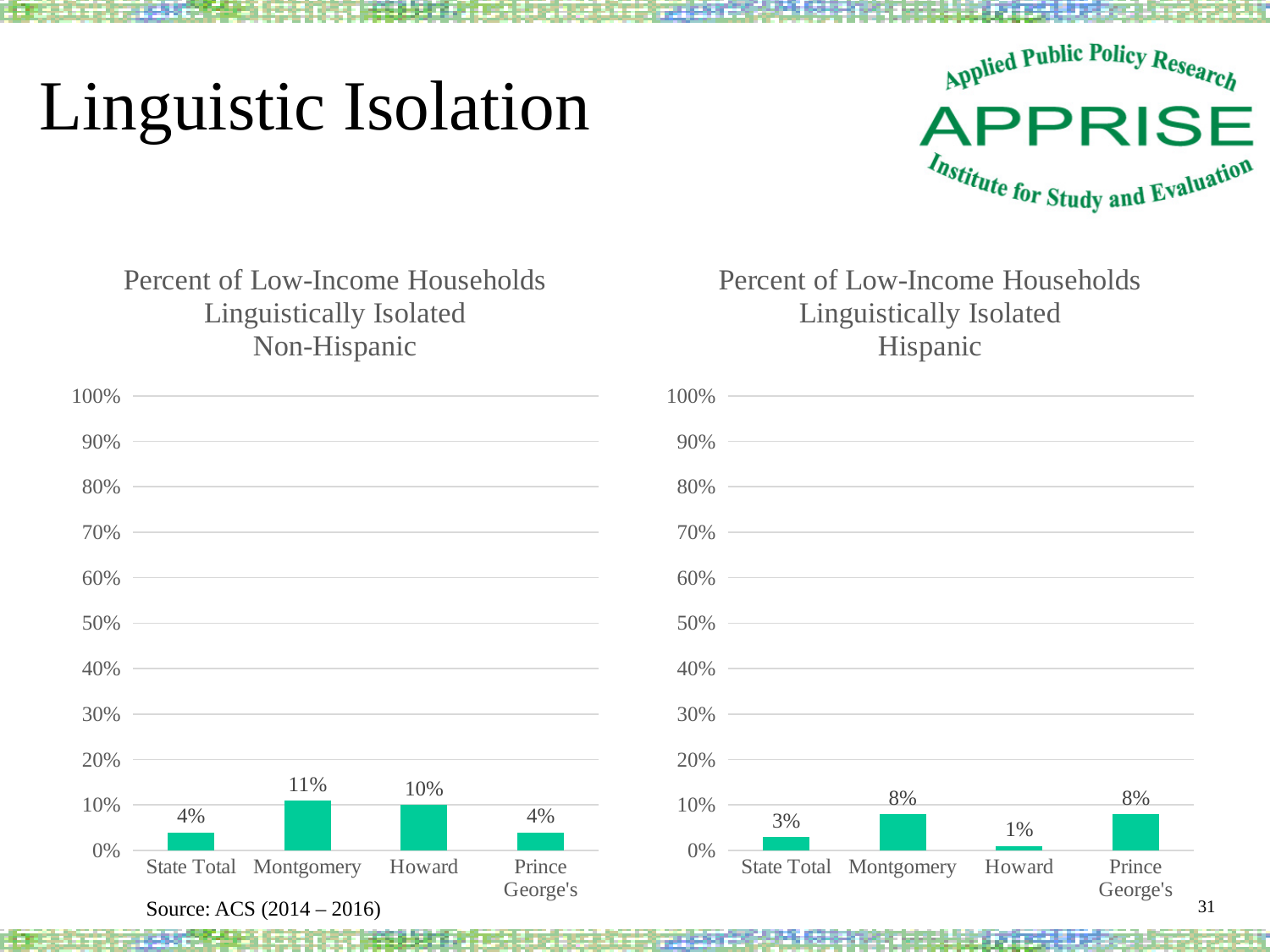
In the Hispanic chart, is the value for Prince George's greater or less than 10%? less How many categories are shown in the Hispanic chart? 4 In the Hispanic chart, what is the value for State Total? 3% In the Hispanic chart, what is the difference between Montgomery and Howard? 7% In the Non-Hispanic chart, which is larger, Howard or Prince George's? Howard What is the title of the chart on the right? Percent of Low-Income Households Linguistically Isolated Hispanic In the Hispanic chart, what is the value for Howard? 1% In the Non-Hispanic chart, which category has the highest value? Montgomery In the Non-Hispanic chart, what is the difference between Montgomery and State Total? 7% What kind of chart is the Non-Hispanic chart? bar chart In the Hispanic chart, which category has the lowest value? Howard In the Non-Hispanic chart, what is the value for Montgomery? 11%